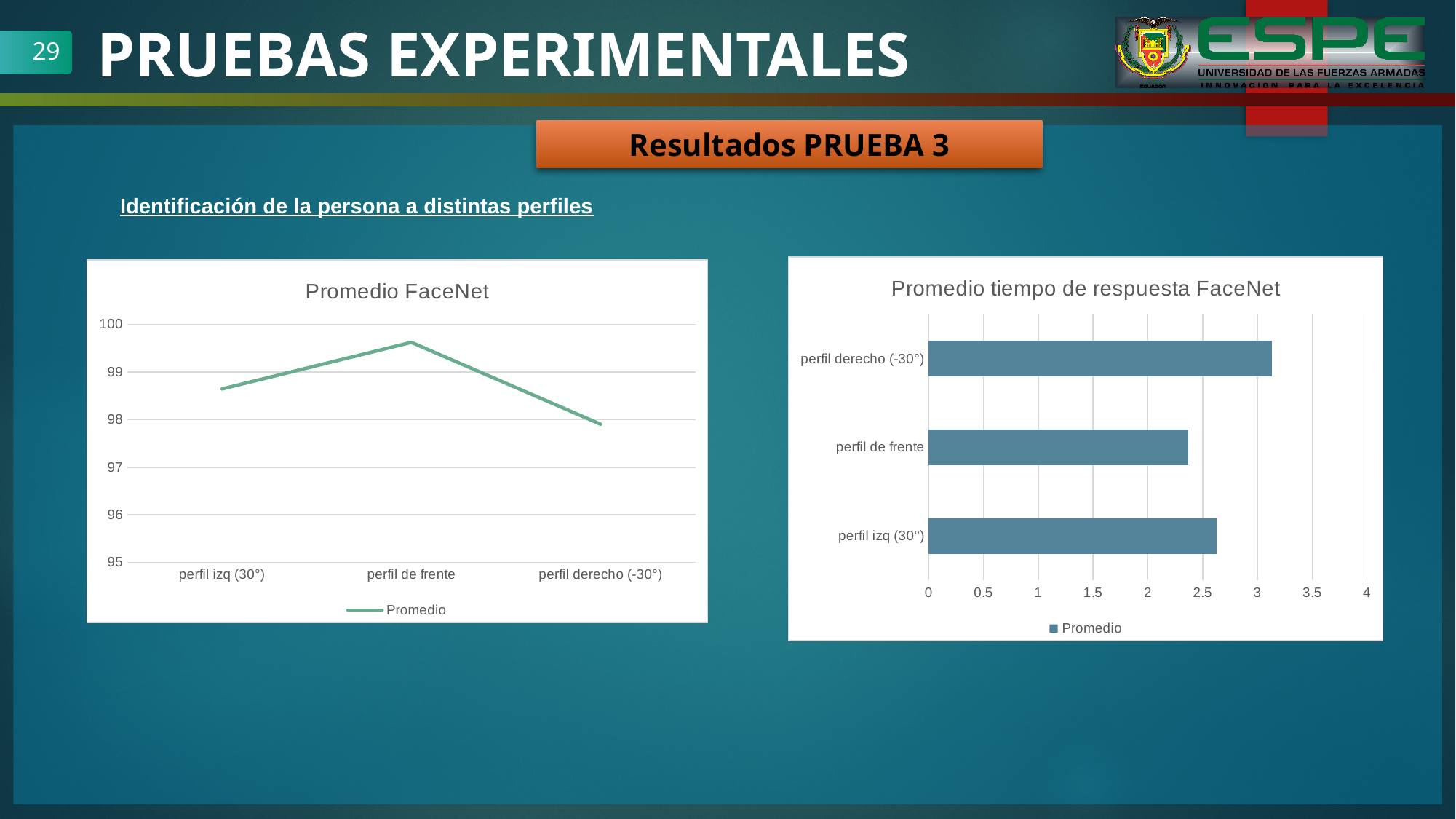
In the "Promedio FaceNet" chart, how many categories are shown on the x axis? 3 What is the legend entry in the "Promedio FaceNet" chart? Promedio In the "Promedio tiempo de respuesta FaceNet" chart, which category has the shortest bar? perfil de frente What kind of chart is "Promedio tiempo de respuesta FaceNet"? bar chart In the "Promedio tiempo de respuesta FaceNet" chart, is the value for perfil derecho (-30°) greater or less than 3? greater In the "Promedio tiempo de respuesta FaceNet" chart, which category has the longest bar? perfil derecho (-30°) In the "Promedio tiempo de respuesta FaceNet" chart, how many series does the legend list? 1 What kind of chart is "Promedio FaceNet"? line chart In the "Promedio FaceNet" chart, which category has the highest value? perfil de frente In the "Promedio tiempo de respuesta FaceNet" chart, which is larger, the value for perfil izq (30°) or perfil de frente? perfil izq (30°) In the "Promedio FaceNet" chart, which category has the lowest value? perfil derecho (-30°)